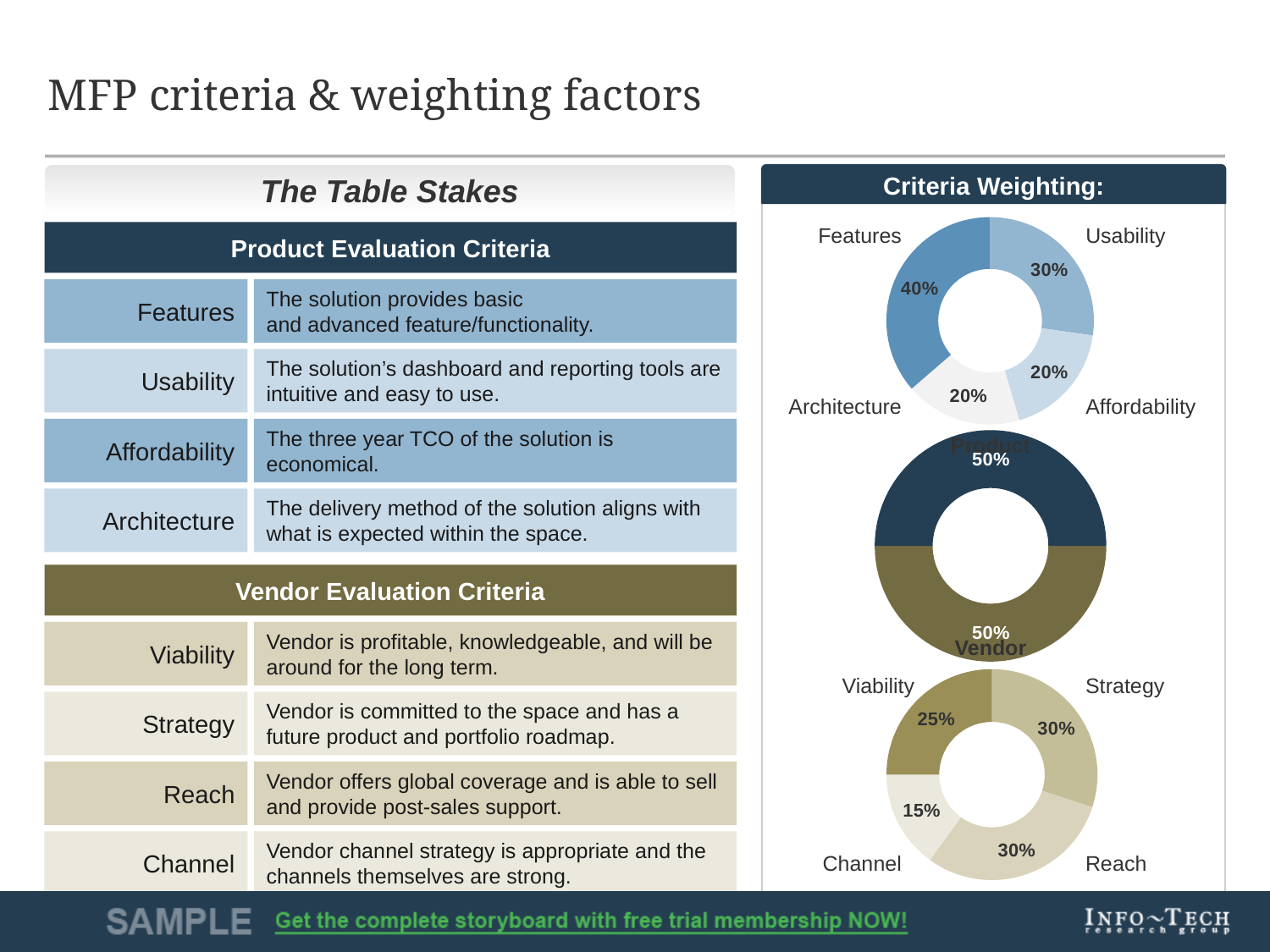
In the bottom donut chart, which criterion has the lowest weighting? Channel In the top donut chart under Criteria Weighting, what is the weighting for Features? 40% In the top donut chart under Criteria Weighting, which criterion has the highest weighting? Features In the top donut chart under Criteria Weighting, what is the difference between the Features and Usability weightings? 10% In the top donut chart under Criteria Weighting, how many criteria are shown? 4 In the middle donut chart, what is the weighting for Product? 50% In the middle donut chart, what is the weighting for Vendor? 50% In the bottom donut chart, what is the weighting for Viability? 25% In the bottom donut chart, which is larger, the weighting for Strategy or the weighting for Viability? Strategy In the top donut chart under Criteria Weighting, what is the weighting for Usability? 30% What type of chart is used to show the criteria weightings on the right side of the slide? Donut chart In the bottom donut chart, what is the weighting for Channel? 15%